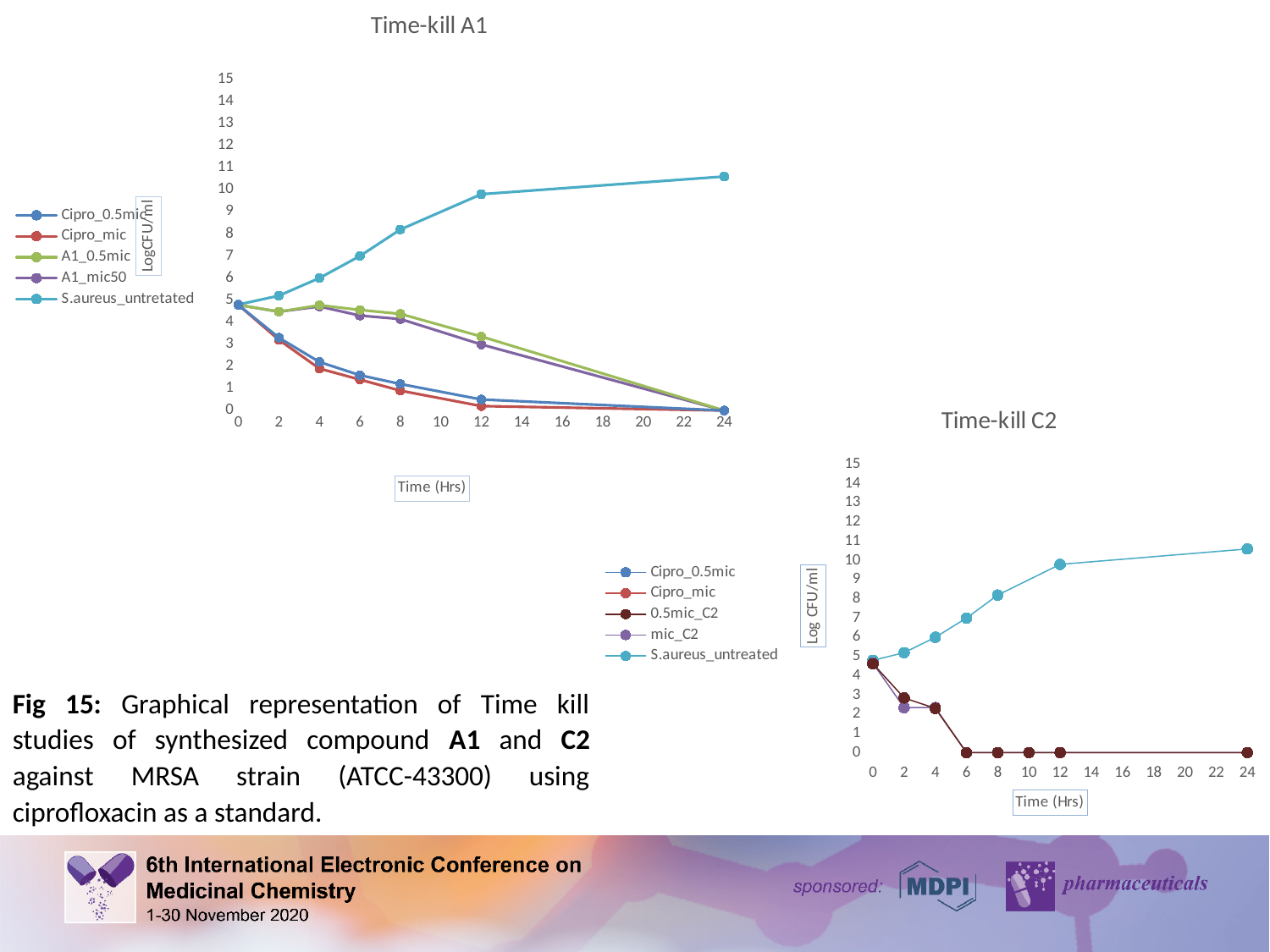
What kind of chart is the Time-kill A1 chart? line chart How many series does the legend of the Time-kill C2 chart list? 5 In the Time-kill A1 chart, at 12 hours, which is larger: A1_0.5mic or Cipro_mic? A1_0.5mic In the Time-kill C2 chart, does the 0.5mic_C2 series rise or fall as time increases? fall In the Time-kill A1 chart, is the value for A1_0.5mic at 12 hours greater or less than 4? less In the Time-kill A1 chart, does the S.aureus_untreated series rise or fall as time increases? rise What is the y-axis title of the Time-kill C2 chart? Log CFU/ml In the Time-kill C2 chart, is the value for 0.5mic_C2 at 6 hours greater or less than 1? less In the Time-kill A1 chart, which series has the highest value at 24 hours? S.aureus_untreated In the Time-kill A1 chart, is the value for S.aureus_untreated at 24 hours greater or less than 10? greater How many series does the legend of the Time-kill A1 chart list? 5